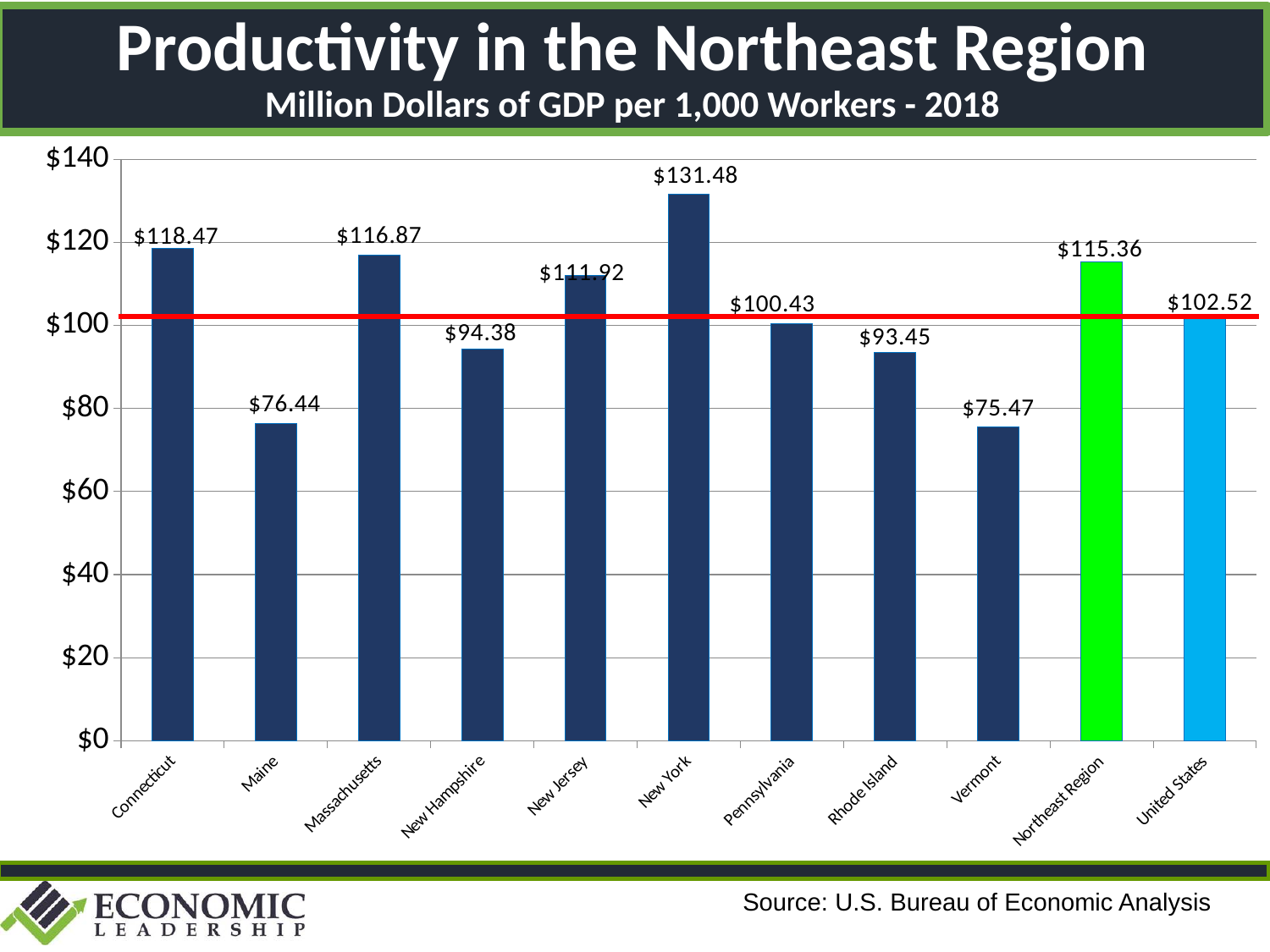
What is the difference between the values for Connecticut and Maine? $42.03 Which category has the highest value? New York What is the value for New York? $131.48 Is the value for Rhode Island greater or less than $100? less What is the difference between the values for the Northeast Region and the United States? $12.84 What kind of chart is shown on the slide? bar chart What is the value for Vermont? $75.47 Which is larger, the value for Massachusetts or the value for New Jersey? Massachusetts What colour is the bar for the Northeast Region? green How many categories are shown on the x axis? 11 What is the value for the Northeast Region? $115.36 Which category has the lowest value? Vermont